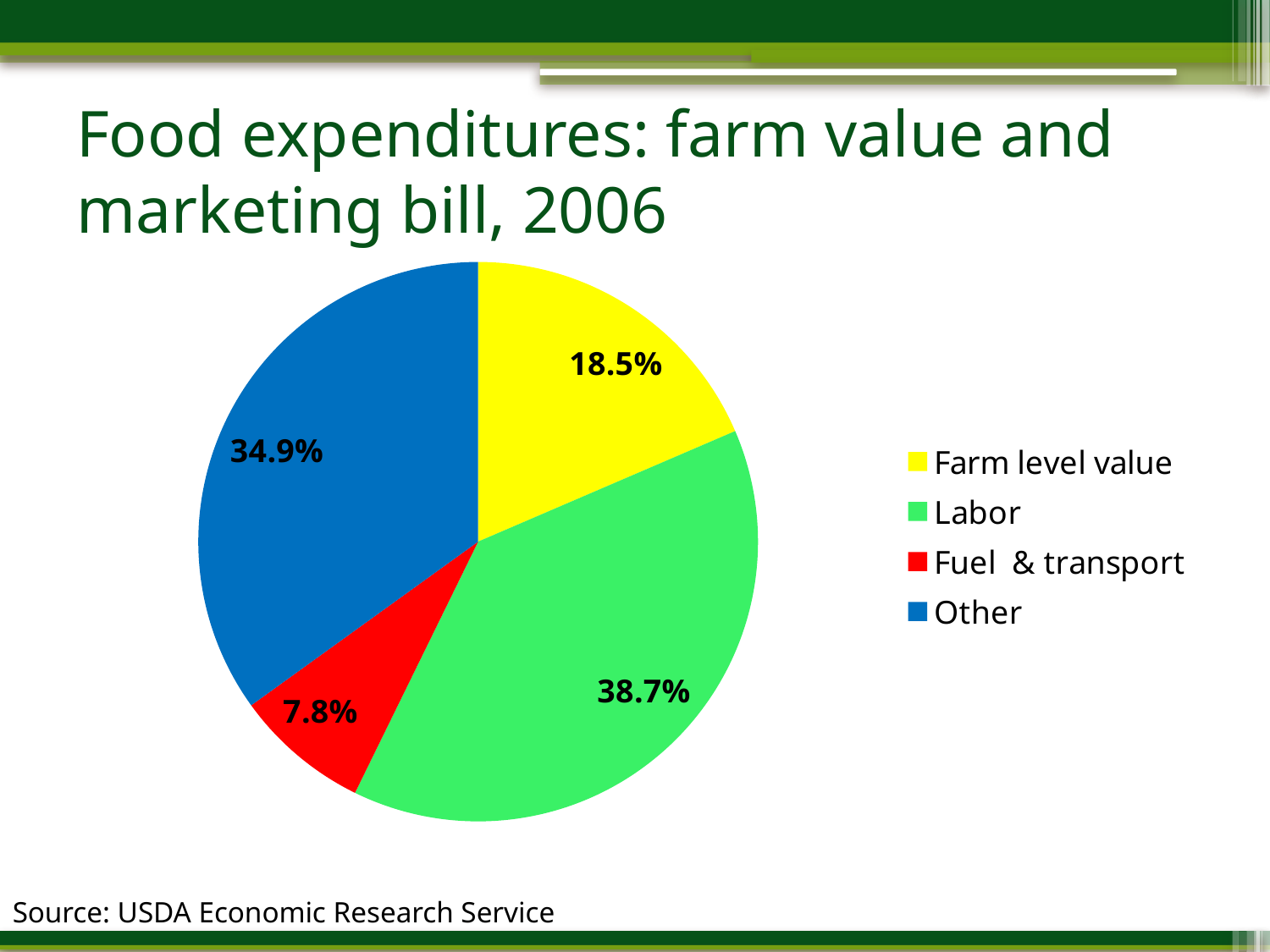
Which category has the largest share of the pie? Labor What share of food expenditures is Farm level value? 18.5% What kind of chart is shown on the slide? Pie chart Which category has the smallest share of the pie? Fuel & transport What share of food expenditures is Other? 34.9% Which is larger, the share for Farm level value or the share for Other? Other How many categories does the pie chart show? 4 What share of food expenditures is Labor? 38.7% What is the difference in percentage points between Farm level value and Fuel & transport? 10.7 What share of food expenditures is Fuel & transport? 7.8% What is the difference in percentage points between Labor and Other? 3.8 What colour is the Labor slice? Green